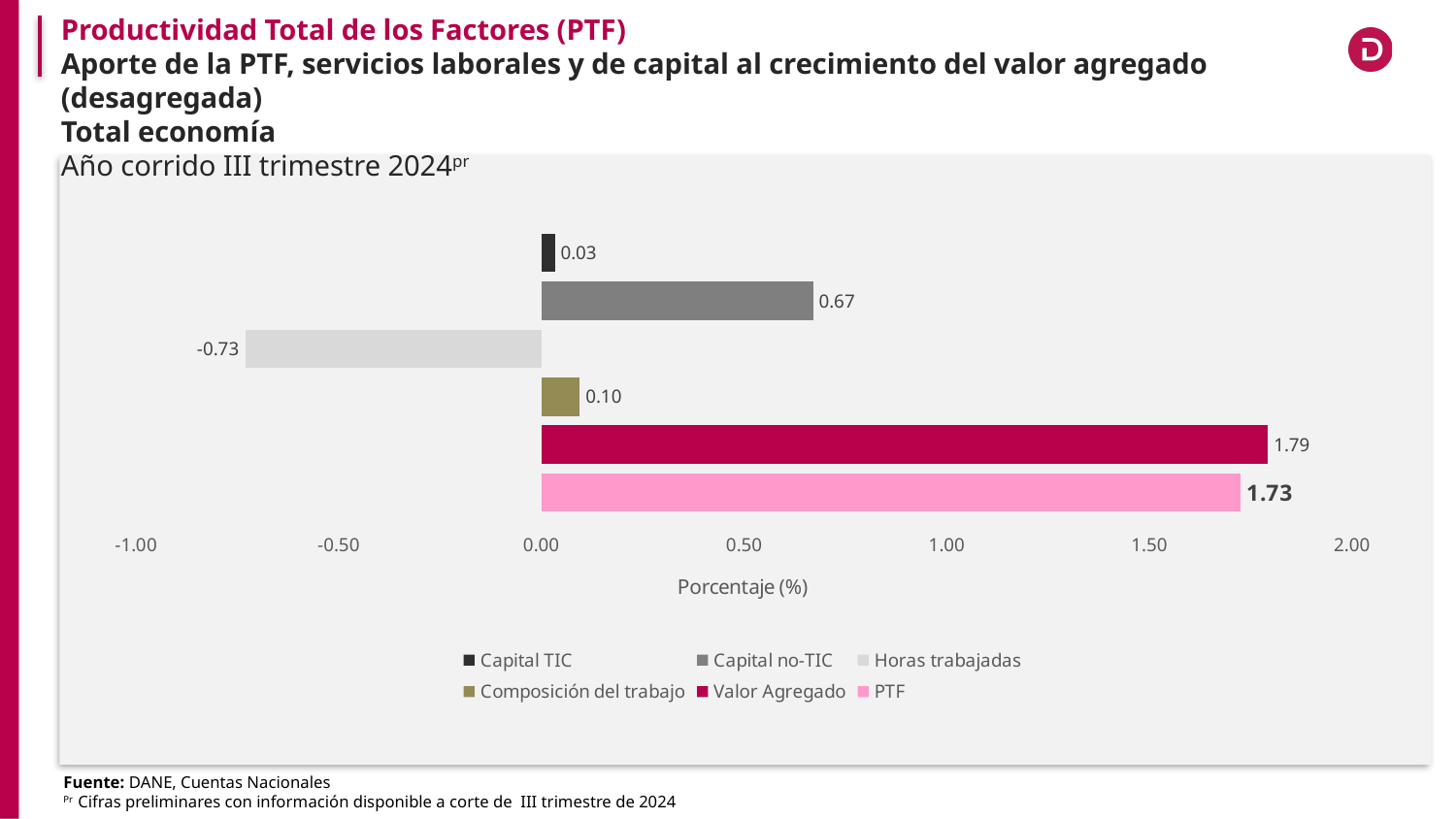
What is the value for PTF? 1.73 What is the value for Capital TIC? 0.03 What is the label of the horizontal axis? Porcentaje (%) Which series has the highest value? Valor Agregado Which is larger, the value for Capital no-TIC or the value for Composición del trabajo? Capital no-TIC What is the value for Horas trabajadas? -0.73 Which series has the lowest value? Horas trabajadas What is the value for Capital no-TIC? 0.67 What kind of chart is shown on the slide? Bar chart How many series does the legend list? 6 What is the difference between the values for Valor Agregado and PTF? 0.06 What is the value for Valor Agregado? 1.79